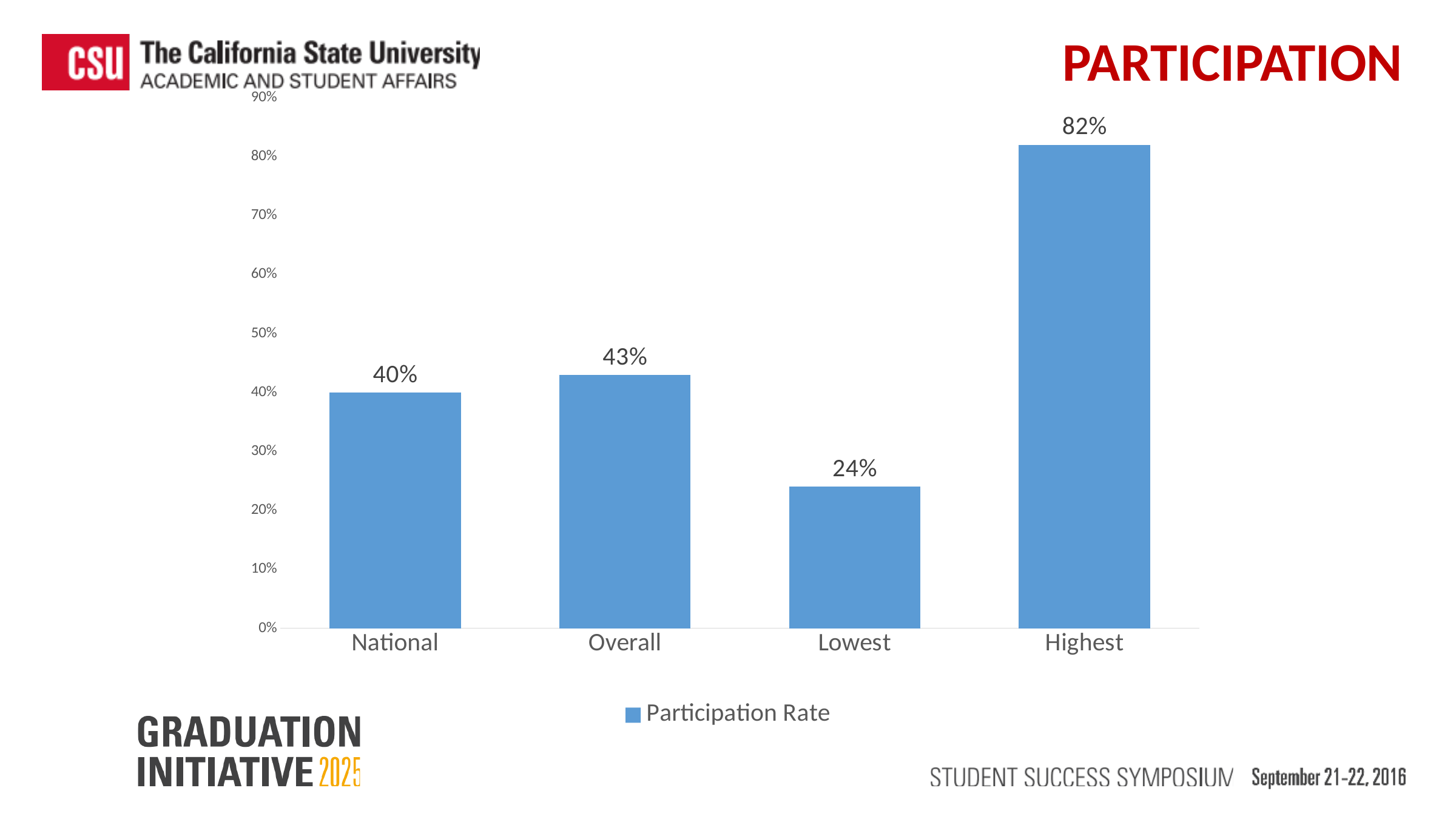
What is the participation rate for Highest? 82% Which is larger, the participation rate for Overall or for Lowest? Overall What kind of chart is shown on the slide? Bar chart What is the participation rate for Overall? 43% What is the difference between the Overall and National participation rates? 3% How many categories are shown on the x axis? 4 What is the participation rate for Lowest? 24% What is the participation rate for National? 40% Which category has the lowest participation rate? Lowest What is the difference between the Highest and Lowest participation rates? 58% What series does the legend list? Participation Rate Which category has the highest participation rate? Highest